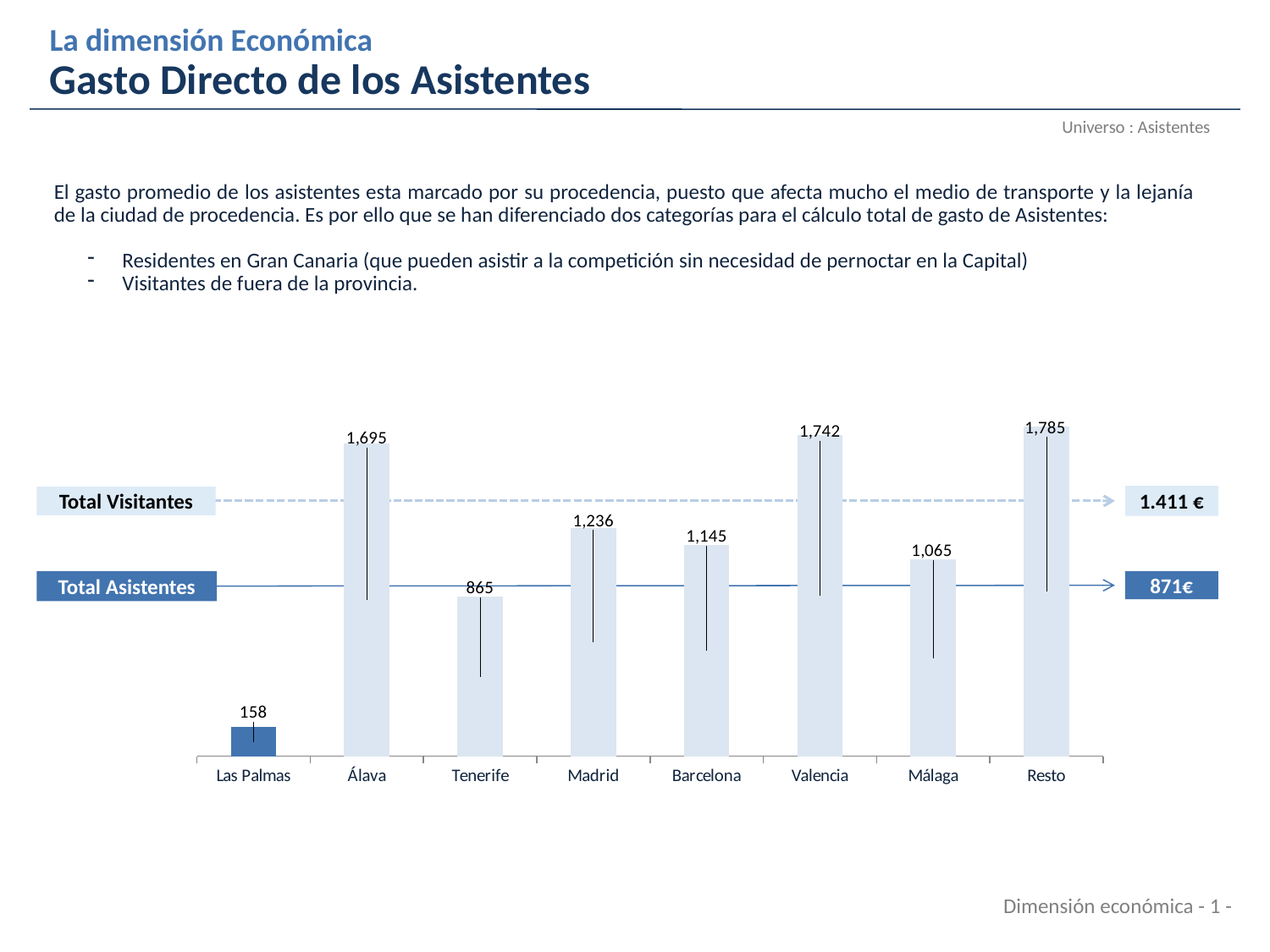
Which category has the lowest value? Las Palmas What is the difference between the values for Resto and Málaga? 720 What kind of chart is shown on the slide? bar chart Which category has the highest value? Resto What value is shown for the Total Visitantes reference line? 1.411 € What is the value for Madrid? 1,236 Which is larger, the value for Álava or the value for Madrid? Álava What is the difference between the values for Valencia and Barcelona? 597 What is the value for Tenerife? 865 How many categories are shown on the x axis? 8 What is the value for Las Palmas? 158 What value is shown for the Total Asistentes reference line? 871€